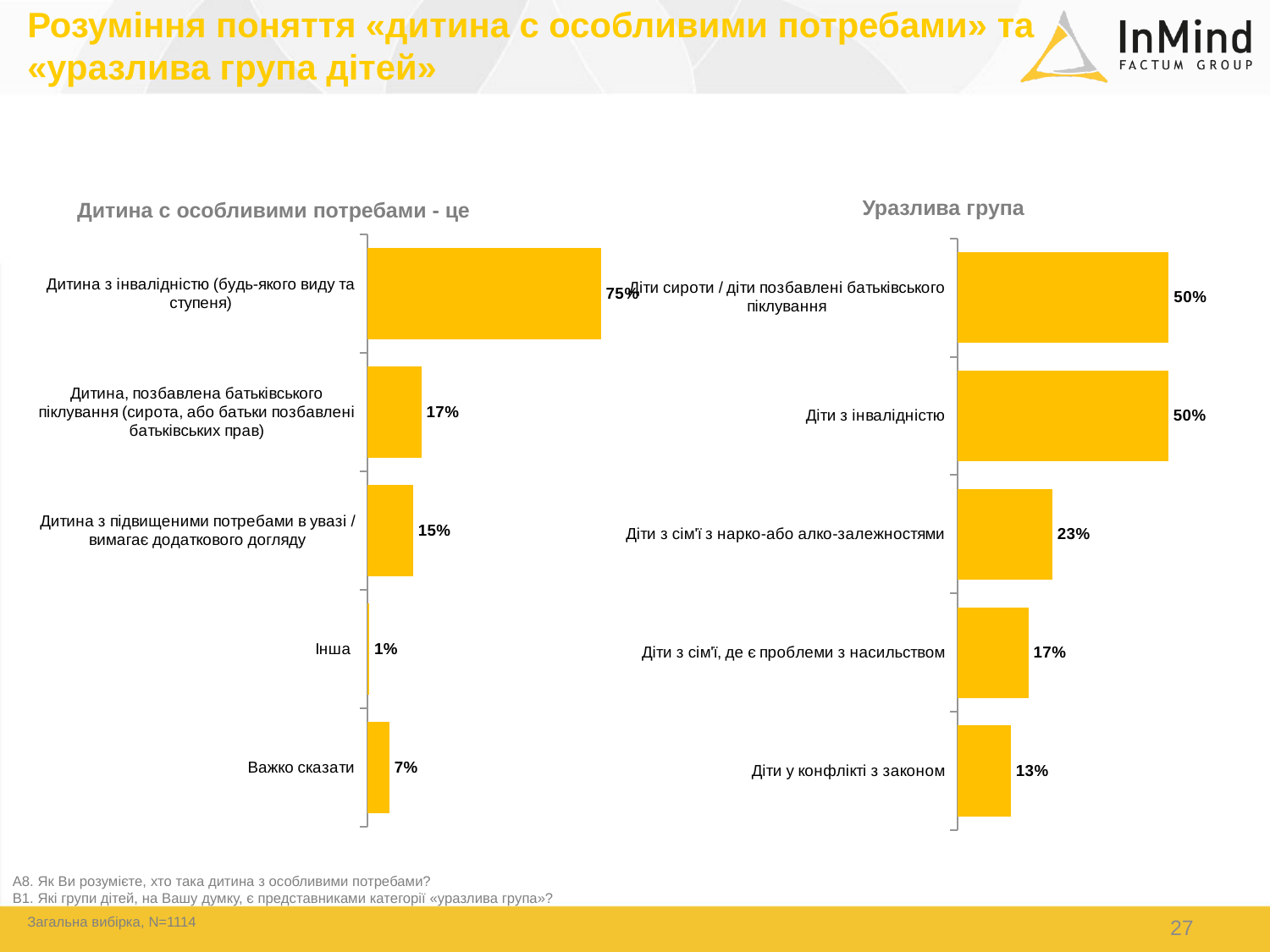
In the chart titled "Уразлива група", which category has the lowest value? Діти у конфлікті з законом In the chart titled "Уразлива група", what is the value for "Діти у конфлікті з законом"? 13% In the chart titled "Дитина с особливими потребами - це", what is the value for "Дитина з інвалідністю (будь-якого виду та ступеня)"? 75% What type of chart is the chart titled "Уразлива група"? Bar chart In the chart titled "Дитина с особливими потребами - це", what is the difference between the values for "Дитина, позбавлена батьківського піклування" and "Дитина з підвищеними потребами в увазі"? 2% In the chart titled "Дитина с особливими потребами - це", what is the value for "Важко сказати"? 7% In the chart titled "Уразлива група", which is larger: the value for "Діти з сім'ї, де є проблеми з насильством" or for "Діти у конфлікті з законом"? Діти з сім'ї, де є проблеми з насильством In the chart titled "Дитина с особливими потребами - це", how many categories are shown? 5 In the chart titled "Уразлива група", what is the difference between the values for "Діти сироти / діти позбавлені батьківського піклування" and "Діти з сім'ї з нарко-або алко-залежностями"? 27% In the chart titled "Дитина с особливими потребами - це", which category has the lowest value? Інша In the chart titled "Дитина с особливими потребами - це", which category has the highest value? Дитина з інвалідністю (будь-якого виду та ступеня) In the chart titled "Уразлива група", what is the value for "Діти з сім'ї з нарко-або алко-залежностями"? 23%